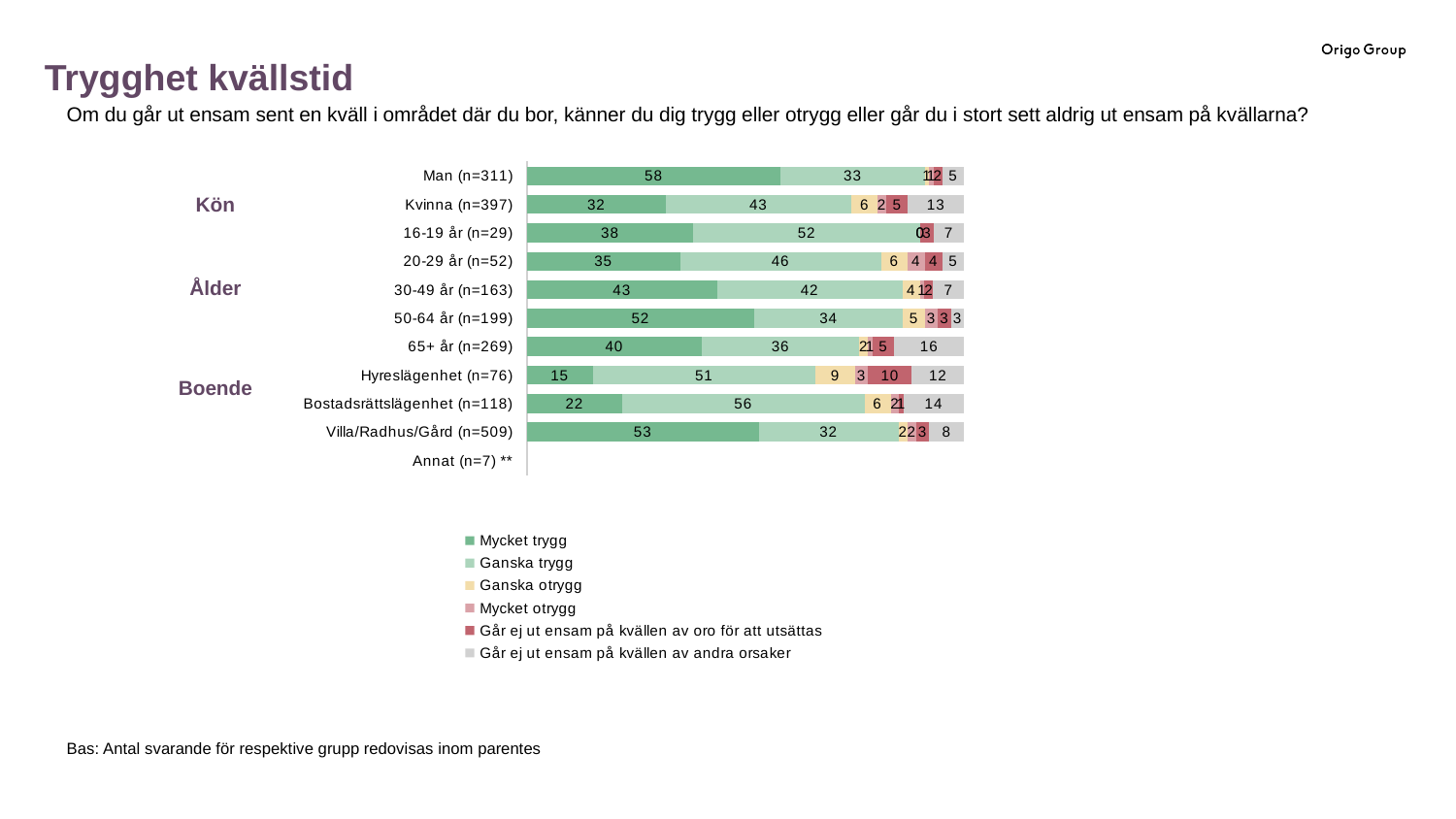
Which has a larger "Ganska trygg" value, 16-19 år (n=29) or 50-64 år (n=199)? 16-19 år (n=29) What is the value of "Går ej ut ensam på kvällen av andra orsaker" for 65+ år (n=269)? 16 What is the value of "Går ej ut ensam på kvällen av oro för att utsättas" for Hyreslägenhet (n=76)? 10 How many series does the legend list? 6 What type of chart is shown on the slide? stacked bar chart Which group has the lowest value for "Mycket trygg"? Hyreslägenhet (n=76) What is the value of "Mycket trygg" for Man (n=311)? 58 What is the difference in "Mycket trygg" between Man (n=311) and Kvinna (n=397)? 26 Which group label is shown with no bar plotted? Annat (n=7) ** What is the value of "Ganska trygg" for Bostadsrättslägenhet (n=118)? 56 Which group has the highest value for "Går ej ut ensam på kvällen av andra orsaker"? 65+ år (n=269) Which group has the highest value for "Mycket trygg"? Man (n=311)